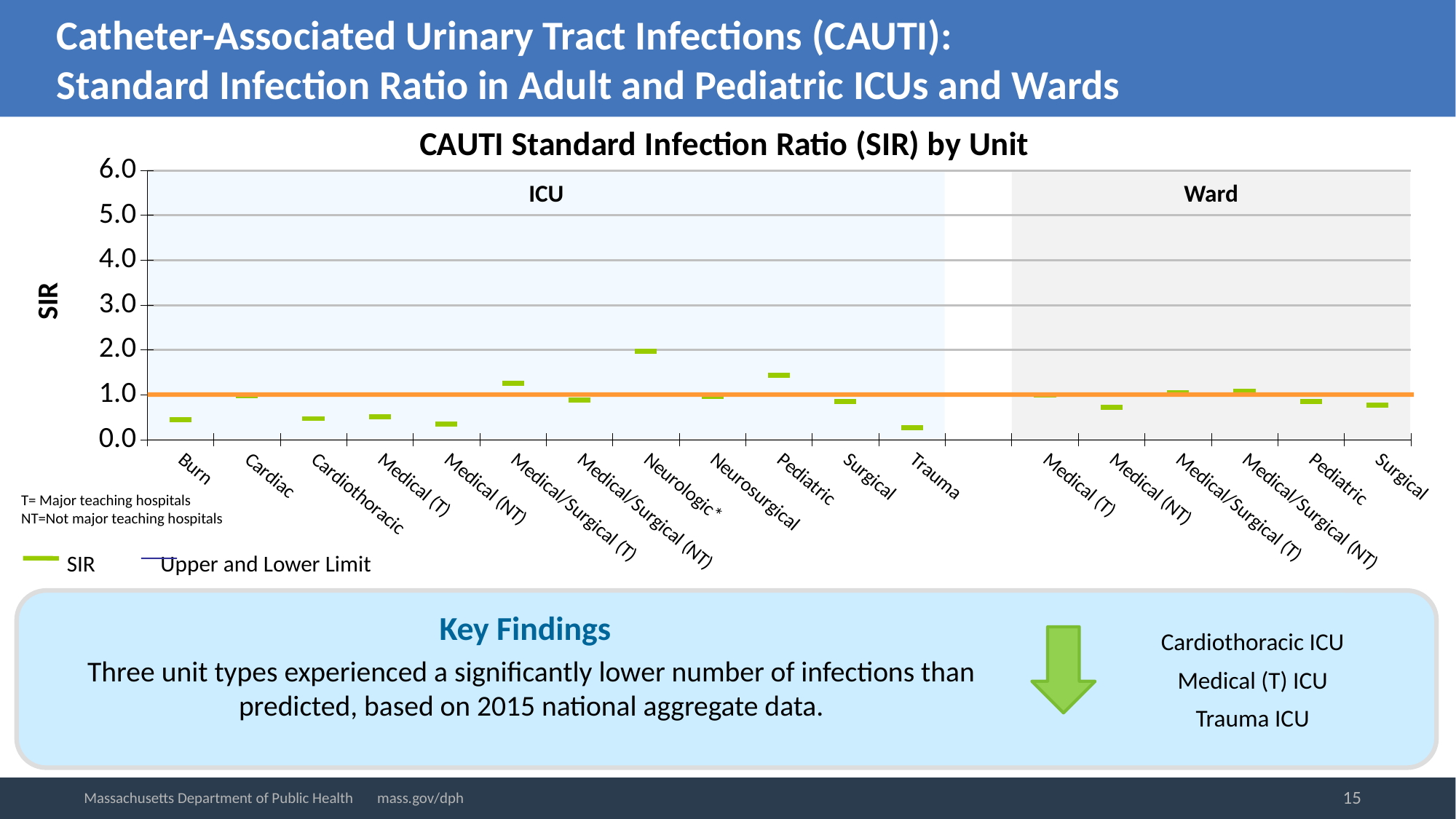
Which unit has the highest SIR on the chart? Neurologic * (ICU) How many unit categories are plotted in the Ward section of the chart? 6 Which unit has the lowest SIR on the chart? Trauma (ICU) Is the SIR for the Pediatric ICU greater or less than 1.0? greater Is the SIR for the Neurologic * ICU greater or less than 1.0? greater What is the title of the chart? CAUTI Standard Infection Ratio (SIR) by Unit What is the label on the vertical axis of the chart? SIR How many unit categories are plotted on the x axis in total? 18 Is the SIR for the Burn ICU greater or less than 1.0? less Which has the larger SIR, the Neurologic * ICU or the Pediatric ICU? Neurologic * ICU How many entries does the chart legend list? 2 How many unit categories are plotted in the ICU section of the chart? 12